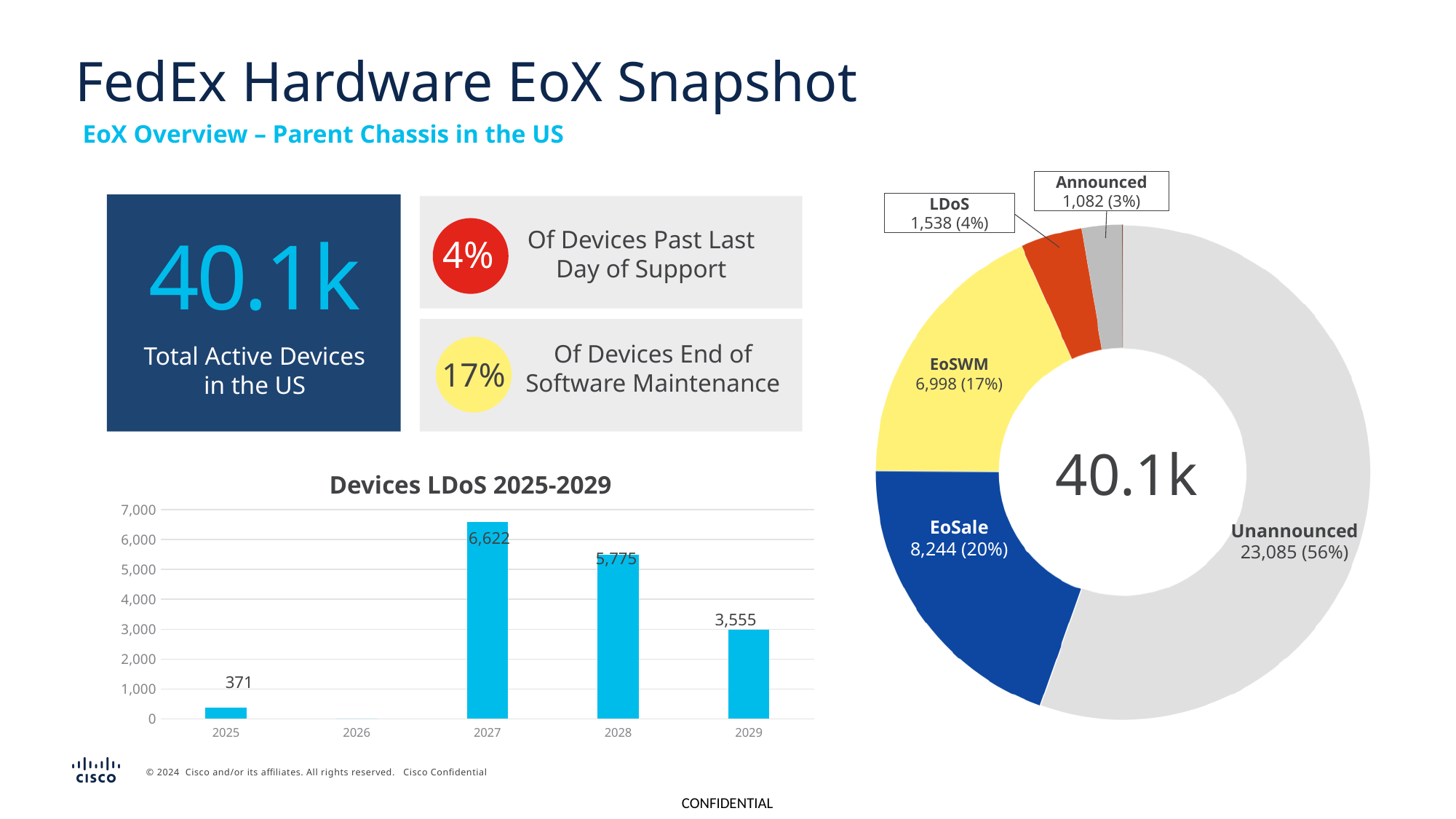
In the donut chart on the right, what is the difference between the Unannounced and EoSale values? 14,841 In the 'Devices LDoS 2025-2029' chart, which year has the highest value? 2027 In the 'Devices LDoS 2025-2029' chart, which year with a bar has the lowest value? 2025 In the 'Devices LDoS 2025-2029' chart, how many years are labelled on the x axis? 5 In the donut chart on the right, what share does EoSale represent? 20% In the 'Devices LDoS 2025-2029' chart, which is larger, the value for 2028 or the value for 2029? 2028 In the donut chart on the right, what is the value for EoSWM? 6,998 (17%) In the 'Devices LDoS 2025-2029' chart, what is the value for 2029? 3,555 In the donut chart on the right, which category is the largest? Unannounced In the 'Devices LDoS 2025-2029' chart, what is the difference between the values for 2027 and 2028? 847 What kind of chart is 'Devices LDoS 2025-2029'? bar chart In the 'Devices LDoS 2025-2029' chart, what is the value for 2027? 6,622